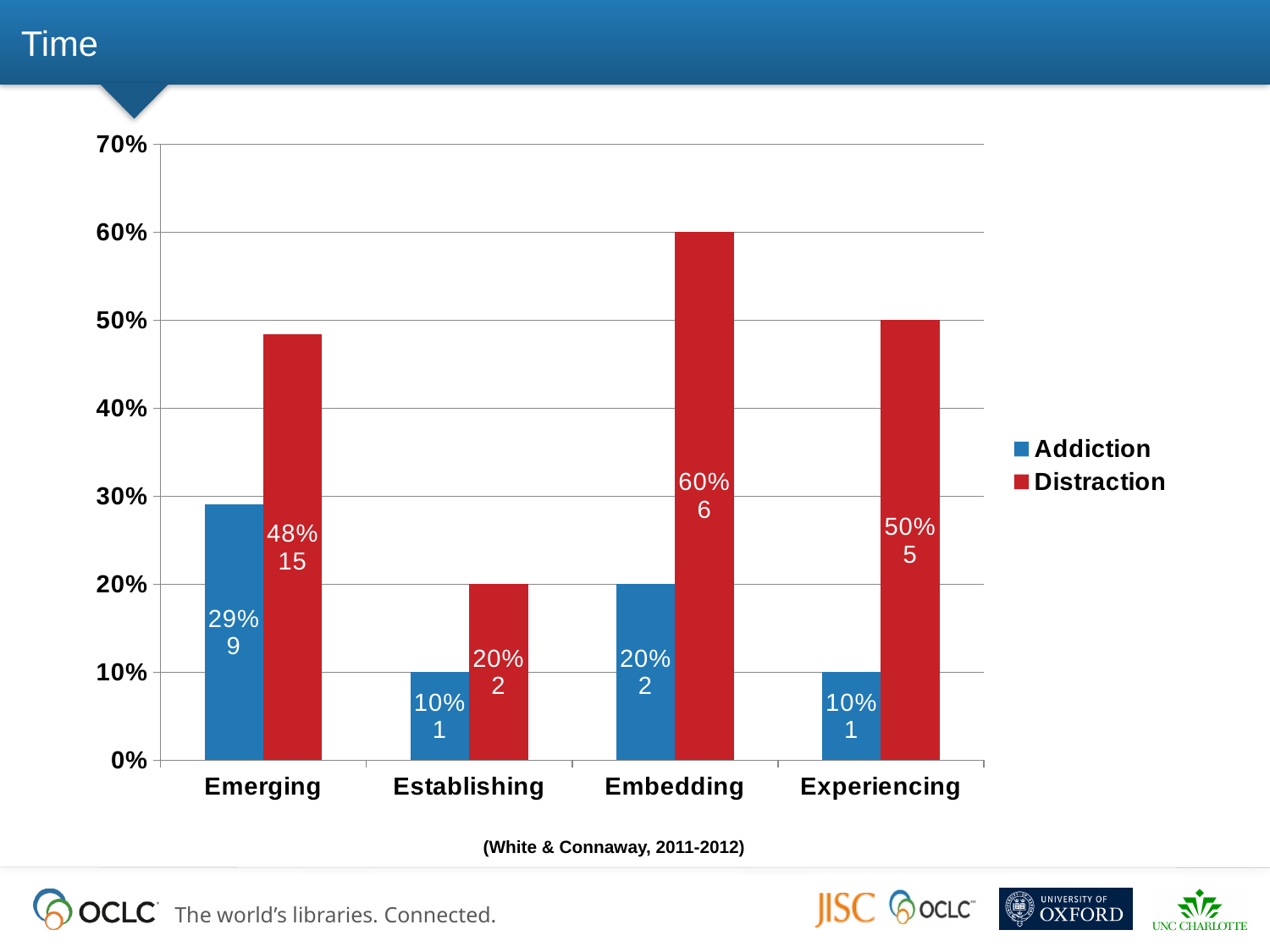
How many series does the legend list? 2 How many categories are shown on the x axis? 4 Which category has the highest Addiction value? Emerging What colour are the Distraction bars? red Which category has the highest Distraction value? Embedding What is the Addiction value for Emerging? 29% What kind of chart is shown on the slide? bar chart Is the Distraction value for Emerging greater or less than 40%? greater Which is larger for Establishing, Addiction or Distraction? Distraction What is the Distraction value for Embedding? 60% What count is shown on the Distraction bar for Emerging? 15 What is the difference between the Distraction and Addiction percentages for Experiencing? 40%